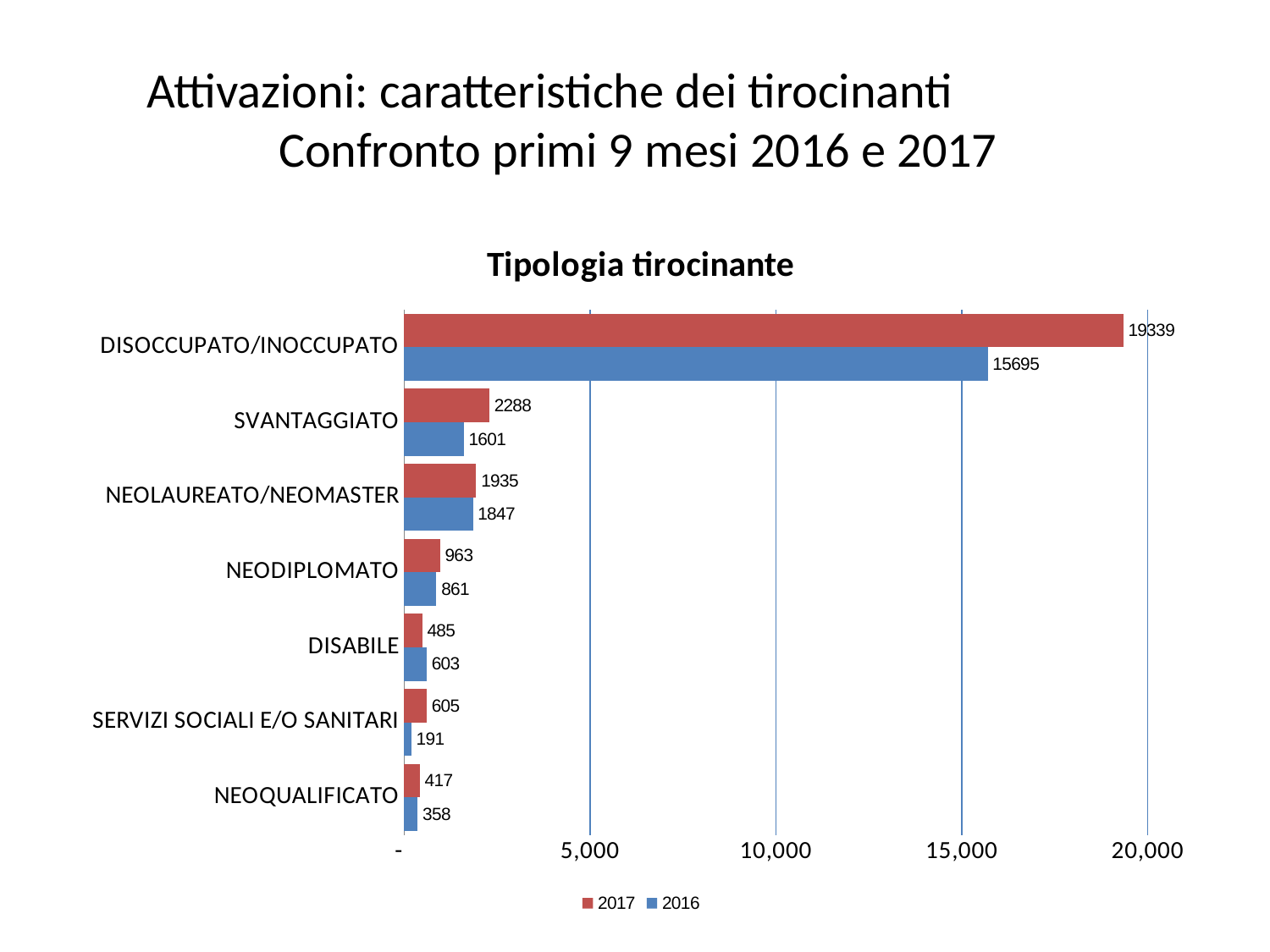
What is the difference between the 2017 and 2016 values for DISOCCUPATO/INOCCUPATO? 3644 How many series does the legend list? 2 What type of chart is shown on the slide? Bar chart What is the 2016 value for SERVIZI SOCIALI E/O SANITARI? 191 What is the 2016 value for SVANTAGGIATO? 1601 For DISABILE, which year has the larger value, 2016 or 2017? 2016 Which category has the highest 2017 value? DISOCCUPATO/INOCCUPATO What is the 2017 value for DISOCCUPATO/INOCCUPATO? 19339 What is the difference between the 2017 and 2016 values for NEODIPLOMATO? 102 Is the 2016 value for DISOCCUPATO/INOCCUPATO greater or less than 15,000? greater Which category has the lowest 2016 value? SERVIZI SOCIALI E/O SANITARI How many categories are shown on the chart? 7